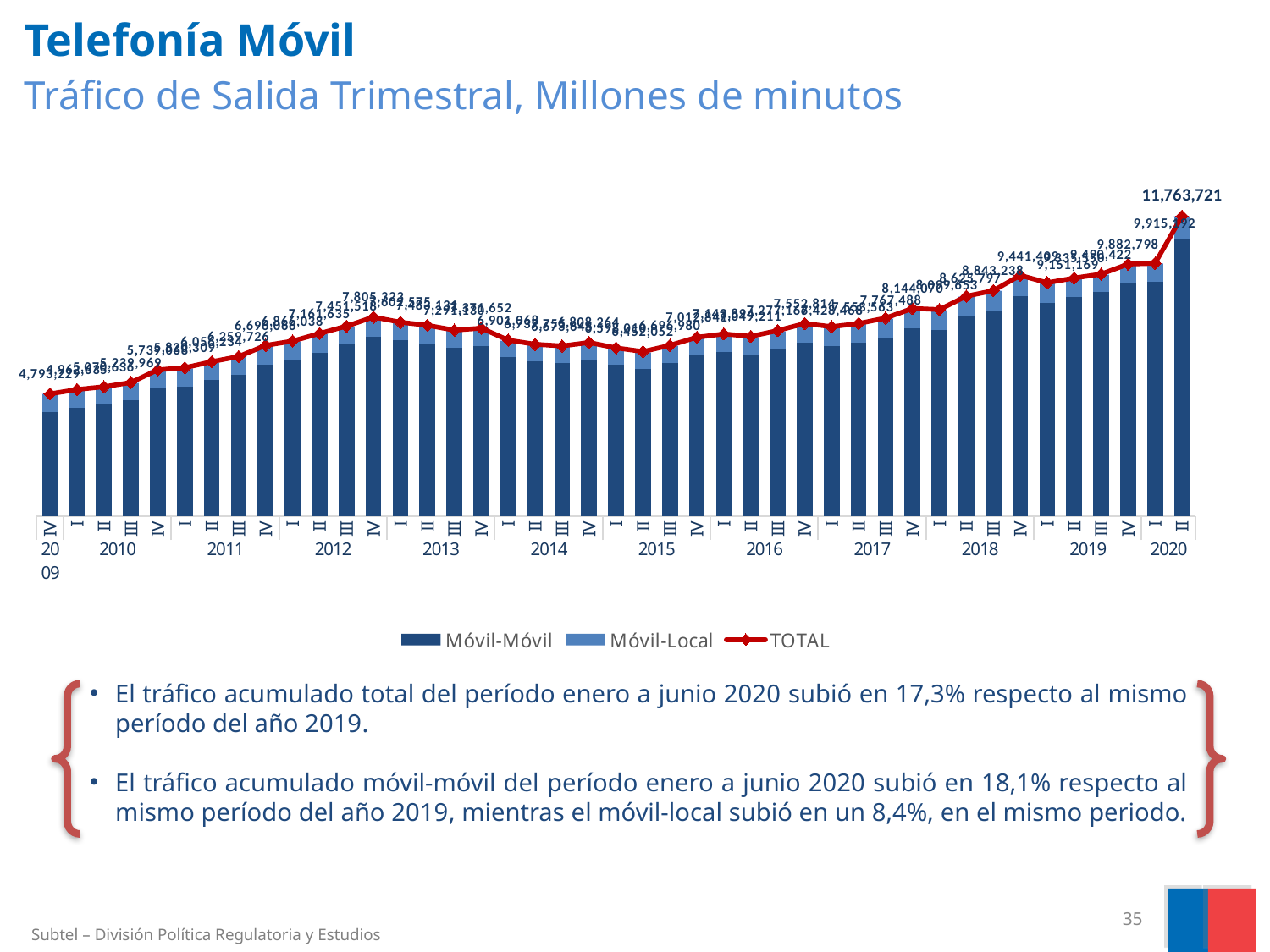
What is the TOTAL value for quarter II of 2020? 11,763,721 What kind of chart is shown on the slide? A combined stacked bar and line chart Which is larger, the TOTAL for II 2020 or the TOTAL for IV 2009? II 2020 How many series does the legend list? 3 Which quarter has the highest TOTAL value? II 2020 What is the difference between the TOTAL for II 2020 and the TOTAL for IV 2009? 6,970,492 Which quarter has the lowest TOTAL value? IV 2009 Overall, does the TOTAL line rise or fall from 2009 to 2020? Rise What are the series names listed in the legend? Móvil-Móvil, Móvil-Local, TOTAL What is the subtitle of the chart on the slide? Tráfico de Salida Trimestral, Millones de minutos In each stacked bar, which segment is larger, Móvil-Móvil or Móvil-Local? Móvil-Móvil What is the TOTAL value for quarter IV of 2009? 4,793,229